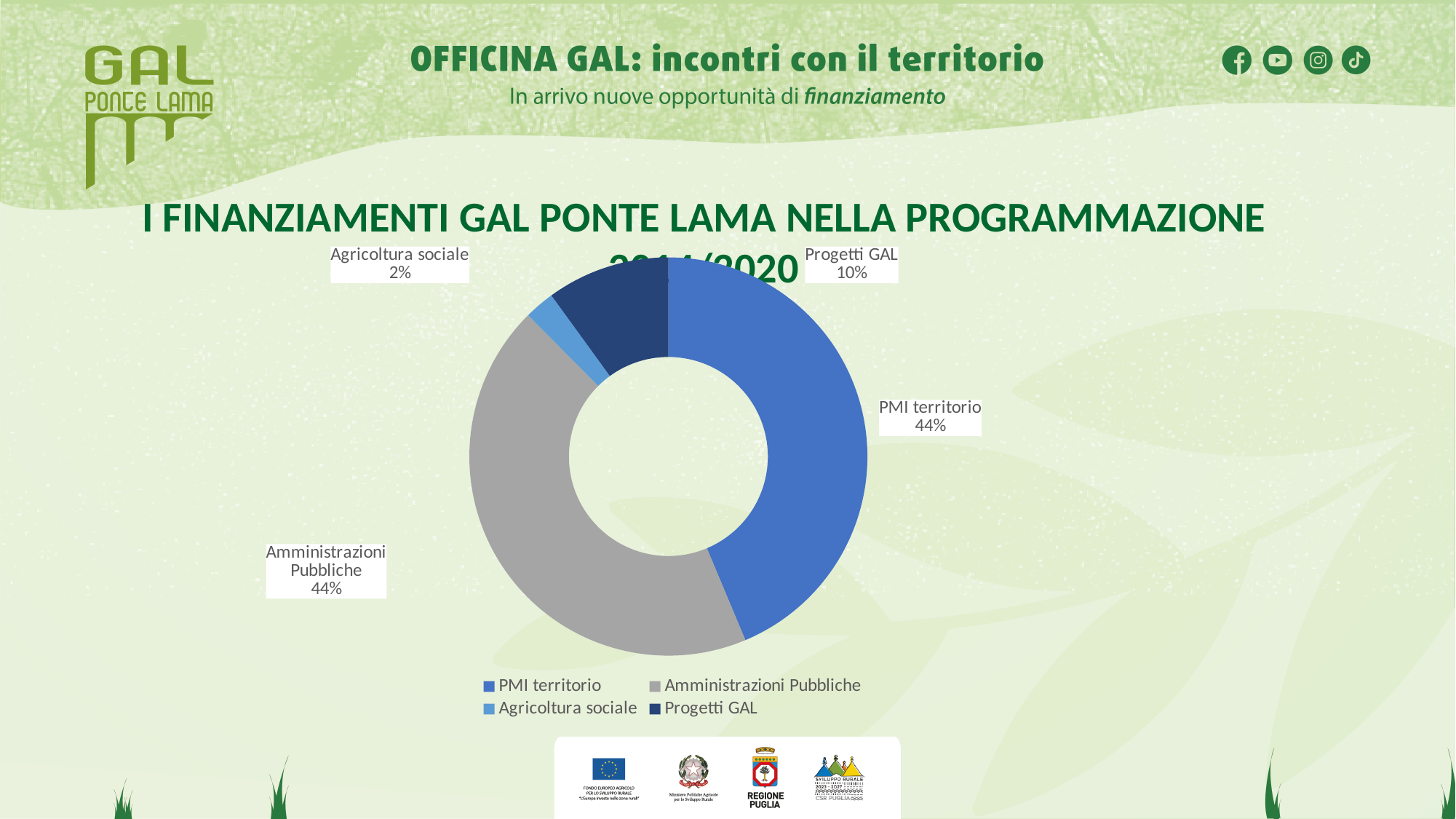
What colour represents Amministrazioni Pubbliche in the chart? Grey What percentage is shown for Progetti GAL? 10% How many entries does the legend list? 4 What kind of chart is shown on the slide? Doughnut (pie) chart By how many percentage points does Progetti GAL exceed Agricoltura sociale? 8 percentage points By how many percentage points does PMI territorio exceed Progetti GAL? 34 percentage points Which is larger, the share for Progetti GAL or the share for Agricoltura sociale? Progetti GAL What share of the funding goes to PMI territorio? 44% Which category has the smallest share of the chart? Agricoltura sociale What percentage is shown for Amministrazioni Pubbliche? 44% What percentage is shown for Agricoltura sociale? 2% How many categories are shown in the chart? 4